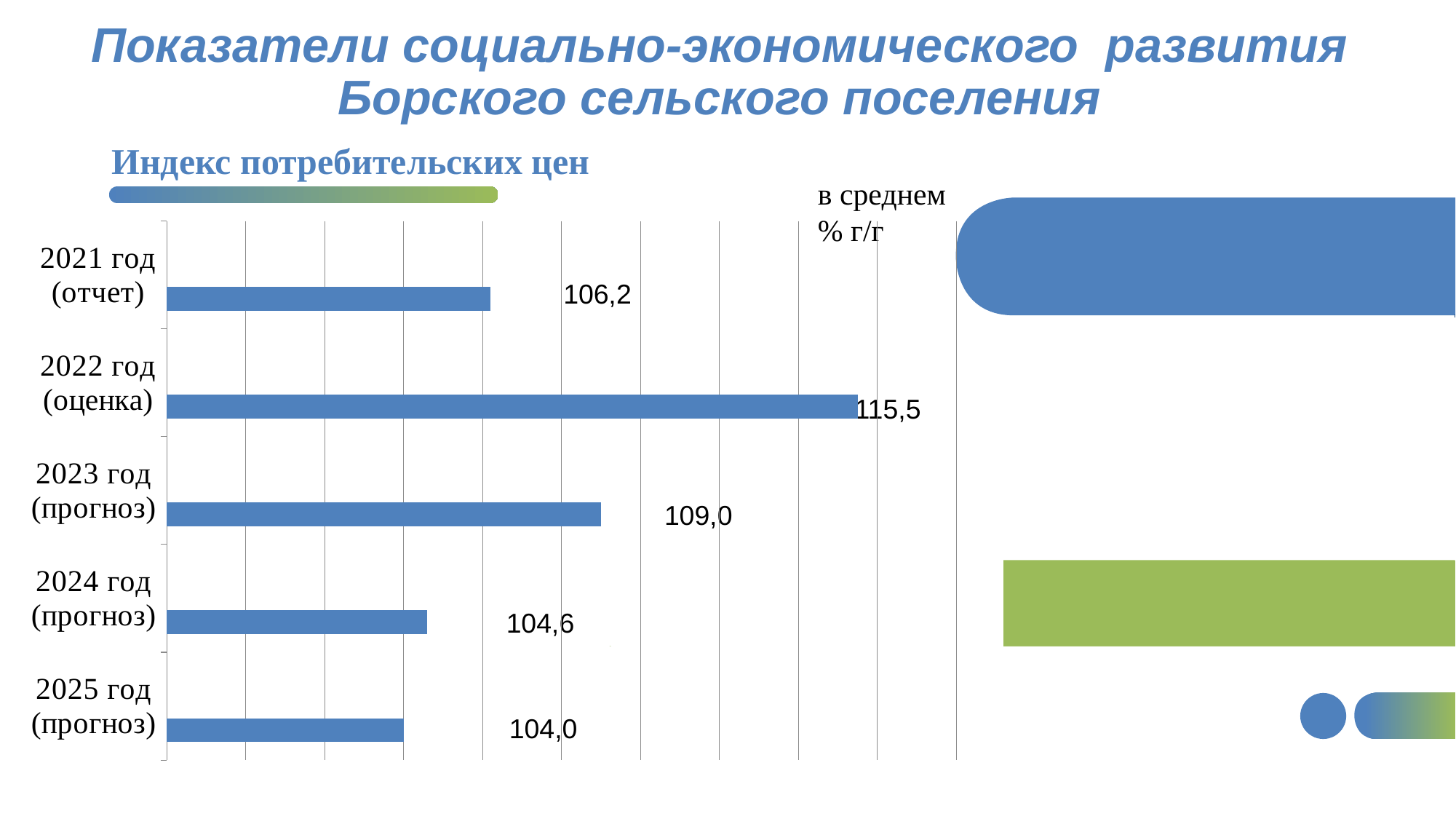
What is the consumer price index value for 2023 год (прогноз)? 109,0 Which is larger, the value for 2021 год (отчет) or the value for 2024 год (прогноз)? 2021 год (отчет) Which year has the lowest consumer price index value? 2025 год (прогноз) What is the title of the chart? Индекс потребительских цен What is the difference between the values for 2022 год (оценка) and 2021 год (отчет)? 9,3 What is the consumer price index value for 2022 год (оценка)? 115,5 How many years (categories) are shown in the chart? 5 What is the consumer price index value for 2021 год (отчет)? 106,2 What is the difference between the values for 2023 год (прогноз) and 2024 год (прогноз)? 4,4 What type of chart is used to show the consumer price index? Bar chart What is the consumer price index value for 2025 год (прогноз)? 104,0 Which year has the highest consumer price index value? 2022 год (оценка)